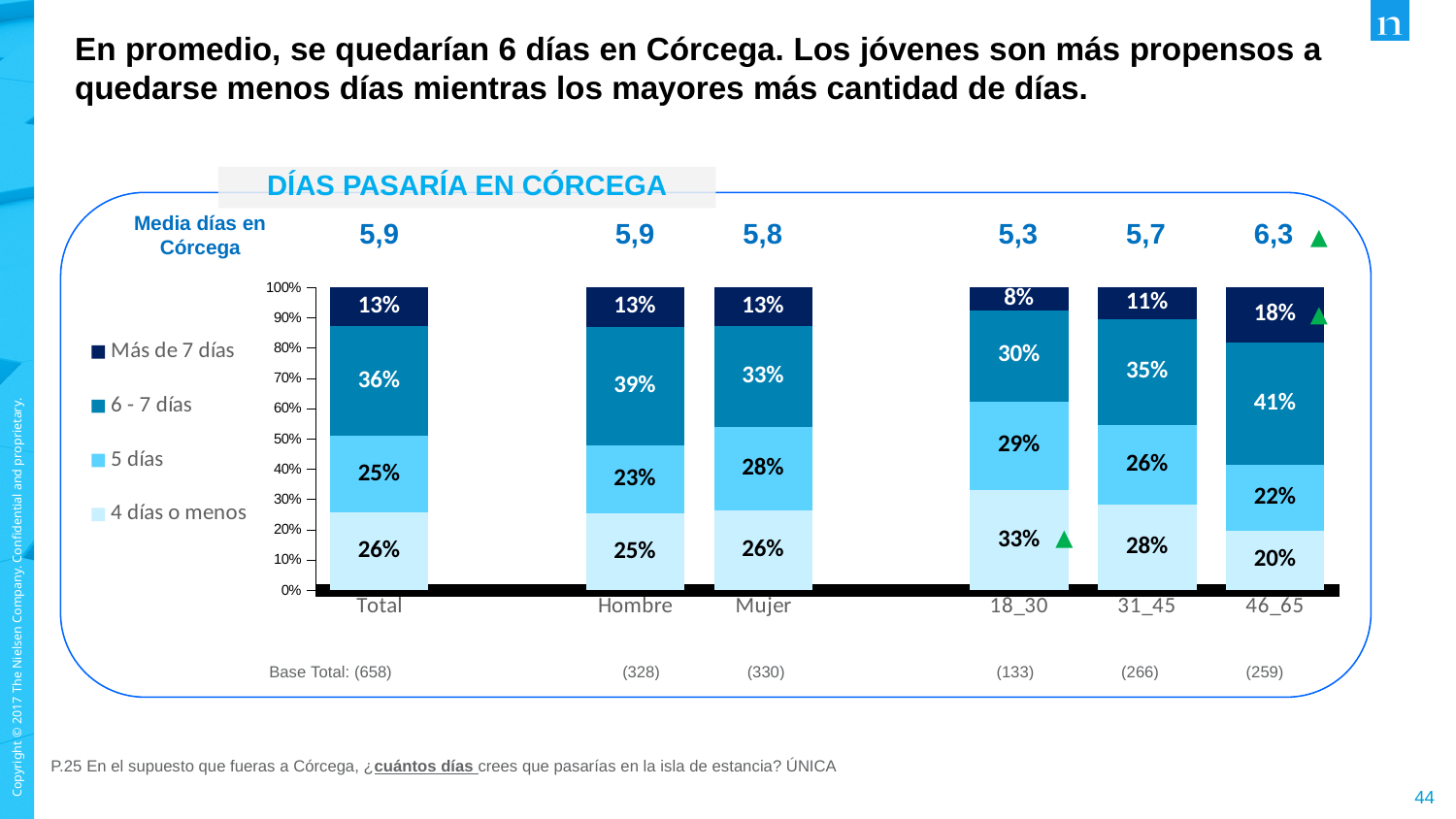
How many series does the legend list? 4 What percentage of the 46_65 group would stay Más de 7 días? 18% How many categories are shown on the x axis of the chart? 6 Which category has the lowest share for Más de 7 días? 18_30 Which category has the highest share for Más de 7 días? 46_65 What percentage of Mujer respondents would stay 5 días? 28% Which is larger: the 4 días o menos share for 18_30 or for 46_65? 18_30 What kind of chart is shown on the slide? Stacked bar chart What percentage of the 18_30 group would stay 4 días o menos? 33% What is the difference between the 6 - 7 días share for Hombre and for Mujer? 6% What percentage of the Total group would stay 6 - 7 días in Córcega? 36% What is the title of the chart? DÍAS PASARÍA EN CÓRCEGA